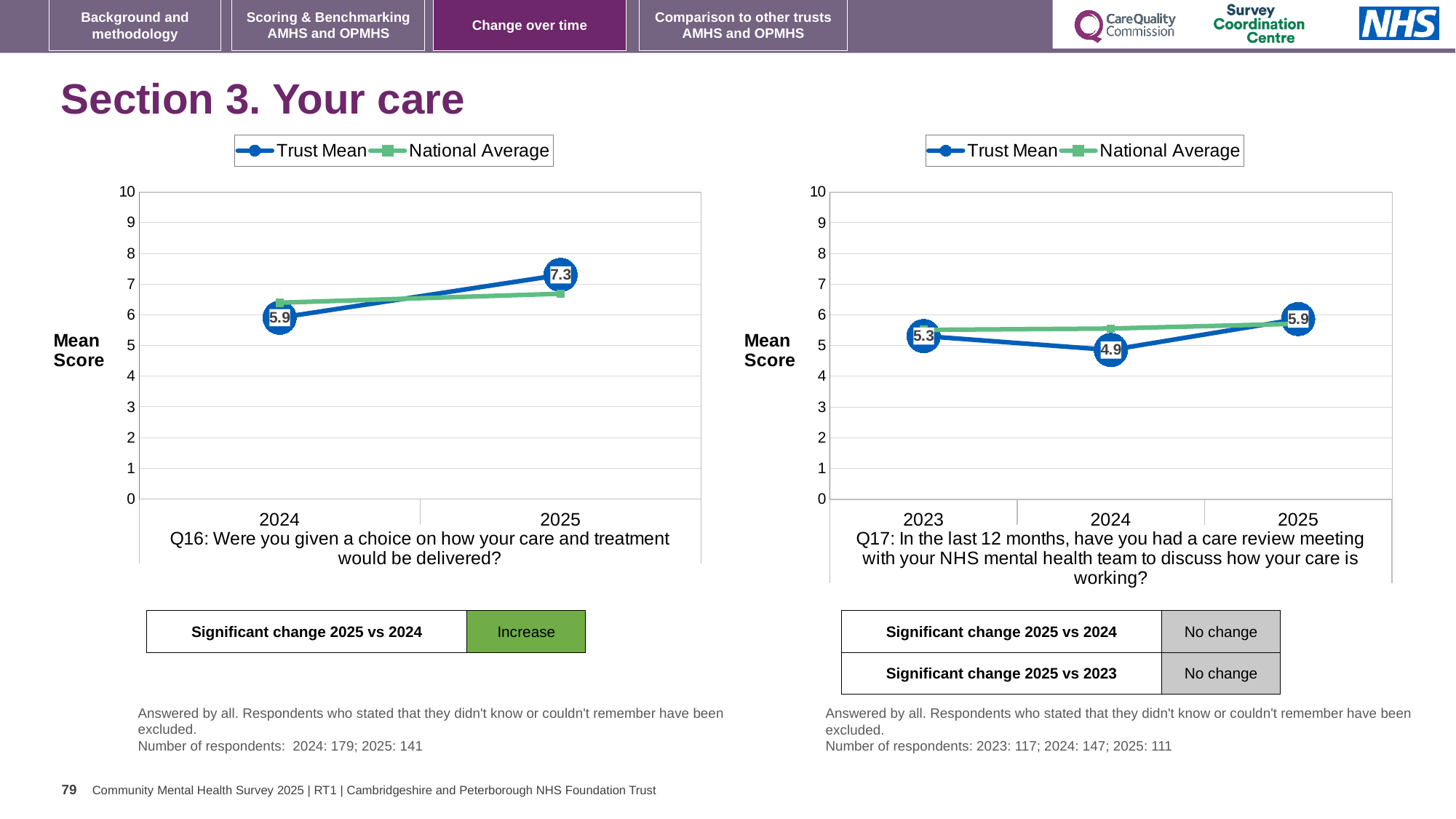
In the Q16 chart on the left, what is the Trust Mean for 2025? 7.3 In the Q17 chart on the right, what is the difference between the Trust Mean for 2025 and 2023? 0.6 In the Q16 chart on the left, by how much did the Trust Mean change from 2024 to 2025? 1.4 In the Q16 chart on the left, what is the Trust Mean for 2024? 5.9 In the Q16 chart on the left, does the Trust Mean rise or fall from 2024 to 2025? rise In the Q17 chart on the right, how many years are shown on the x axis? 3 How many series does the legend of the Q16 chart on the left list? 2 In the Q17 chart on the right, what is the Trust Mean for 2024? 4.9 What type of chart is the Q17 chart on the right? line chart In the Q17 chart on the right, which year has the highest Trust Mean? 2025 In the Q17 chart on the right, which year has the lowest Trust Mean? 2024 In the Q16 chart on the left, is the National Average for 2025 greater or less than 7? less